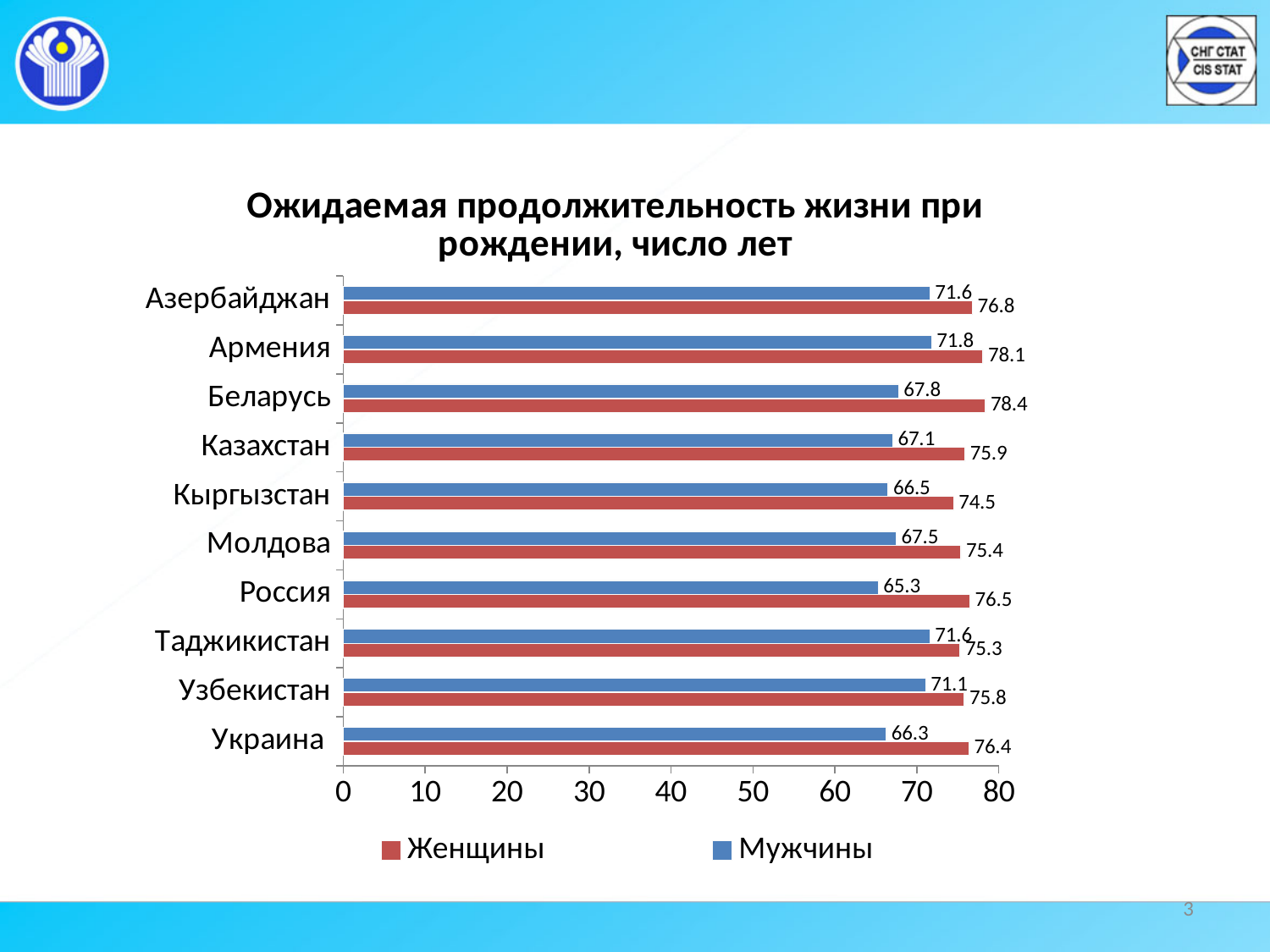
How many series does the legend list? 2 What is the life expectancy for men (Мужчины) in Россия? 65.3 Which country has the highest value for Женщины? Беларусь What type of chart is shown on the slide? bar chart What is the difference between the Женщины and Мужчины values for Беларусь? 10.6 Which country has the lowest value for Мужчины? Россия Which country has the lowest value for Женщины? Кыргызстан Is the value for Мужчины in Украина greater or less than 70? less What is the value for Мужчины in Узбекистан? 71.1 How many countries are shown on the chart? 10 What is the life expectancy for women (Женщины) in Беларусь? 78.4 Which is larger: the Мужчины value for Армения or for Казахстан? Армения